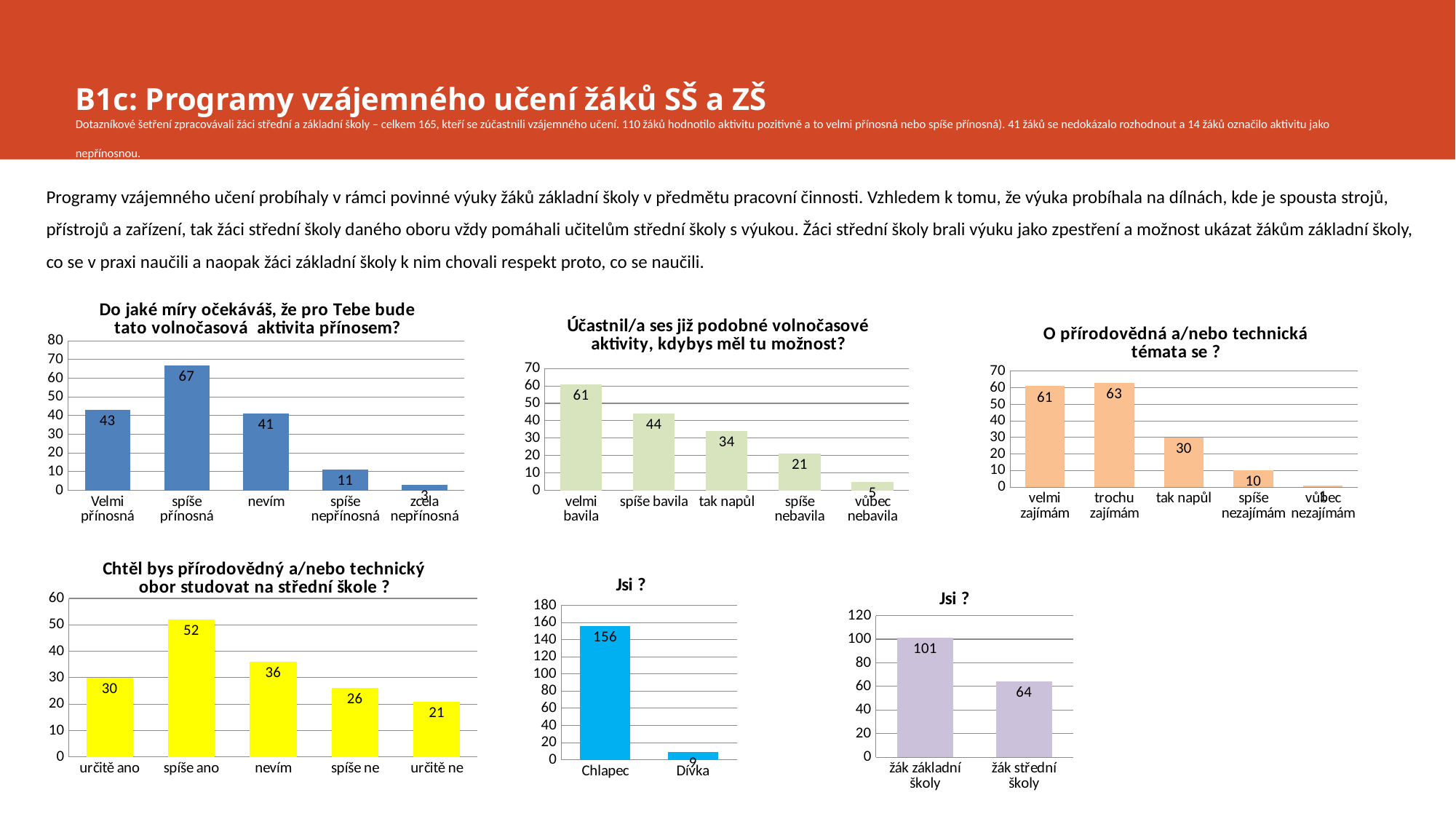
In the top-right chart 'O přírodovědná a/nebo technická témata se ?', which category has the highest value? trochu zajímám In the bottom-right chart 'Jsi ?' (žák základní školy / žák střední školy), what is the difference between 'žák základní školy' and 'žák střední školy'? 37 What type of chart is the bottom-right chart 'Jsi ?' (žák základní školy / žák střední školy)? bar chart In the top-middle chart 'Účastnil/a ses již podobné volnočasové aktivity, kdybys měl tu možnost?', what is the value for 'tak napůl'? 34 In the bottom-left chart 'Chtěl bys přírodovědný a/nebo technický obor studovat na střední škole ?', how many categories are shown? 5 In the top-right chart 'O přírodovědná a/nebo technická témata se ?', what is the value for 'spíše nezajímám'? 10 In the bottom-left chart 'Chtěl bys přírodovědný a/nebo technický obor studovat na střední škole ?', which is larger, 'určitě ano' or 'nevím'? nevím In the top-middle chart 'Účastnil/a ses již podobné volnočasové aktivity, kdybys měl tu možnost?', do the values rise or fall from left to right along the x axis? fall In the top-left chart 'Do jaké míry očekáváš, že pro Tebe bude tato volnočasová aktivita přínosem?', what is the difference between 'Velmi přínosná' and 'nevím'? 2 In the bottom-middle chart 'Jsi ?' (Chlapec / Dívka), what is the value for 'Chlapec'? 156 In the top-left chart 'Do jaké míry očekáváš, že pro Tebe bude tato volnočasová aktivita přínosem?', what is the value for 'spíše přínosná'? 67 In the top-left chart 'Do jaké míry očekáváš, že pro Tebe bude tato volnočasová aktivita přínosem?', which category has the lowest value? zcela nepřínosná